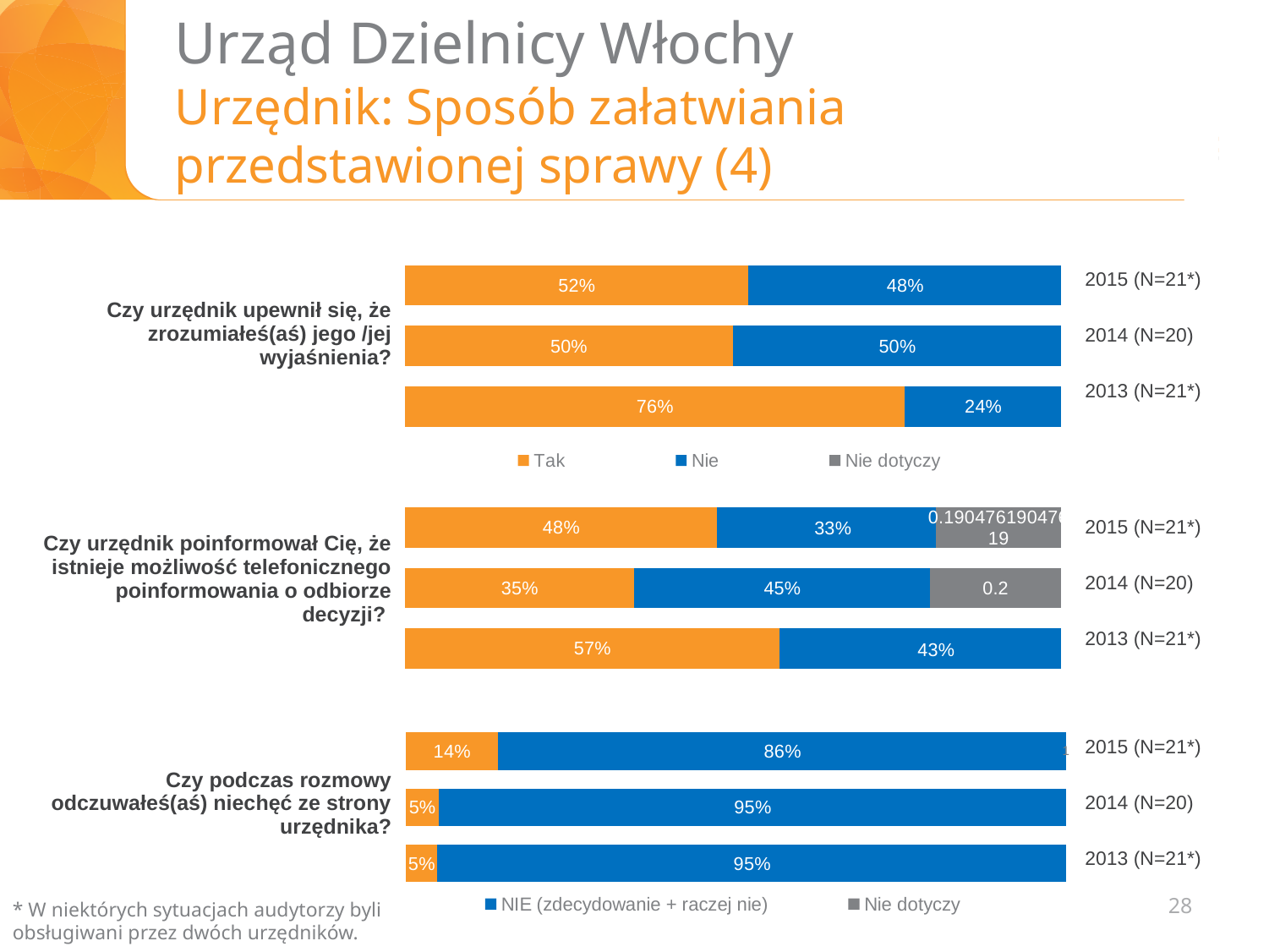
In the chart for "Czy urzędnik poinformował Cię, że istnieje możliwość telefonicznego poinformowania o odbiorze decyzji?", is the Tak value for 2015 larger or smaller than the Nie value for 2015? larger In the chart for "Czy urzędnik upewnił się, że zrozumiałeś(aś) jego /jej wyjaśnienia?", what is the Nie value for 2013 (N=21*)? 24% What type of chart is used on this slide? Stacked bar chart In the chart for "Czy urzędnik upewnił się, że zrozumiałeś(aś) jego /jej wyjaśnienia?", what is the difference between the Tak values for 2013 and 2014? 26% In the chart for "Czy urzędnik poinformował Cię, że istnieje możliwość telefonicznego poinformowania o odbiorze decyzji?", what is the Nie value for 2014 (N=20)? 45% In the chart for "Czy urzędnik upewnił się, że zrozumiałeś(aś) jego /jej wyjaśnienia?", which year has the highest Tak value? 2013 (N=21*) In the chart for "Czy podczas rozmowy odczuwałeś(aś) niechęć ze strony urzędnika?", what is the NIE (zdecydowanie + raczej nie) value for 2014 (N=20)? 95% In the chart for "Czy urzędnik upewnił się, że zrozumiałeś(aś) jego /jej wyjaśnienia?", what is the Tak value for 2015 (N=21*)? 52% In the chart for "Czy podczas rozmowy odczuwałeś(aś) niechęć ze strony urzędnika?", what is the NIE (zdecydowanie + raczej nie) value for 2015 (N=21*)? 86% In the chart for "Czy urzędnik upewnił się, że zrozumiałeś(aś) jego /jej wyjaśnienia?", how many entries does the legend list? 3 In the chart for "Czy urzędnik poinformował Cię, że istnieje możliwość telefonicznego poinformowania o odbiorze decyzji?", what is the Tak value for 2013 (N=21*)? 57% In the chart for "Czy urzędnik poinformował Cię, że istnieje możliwość telefonicznego poinformowania o odbiorze decyzji?", which year has the lowest Tak value? 2014 (N=20)